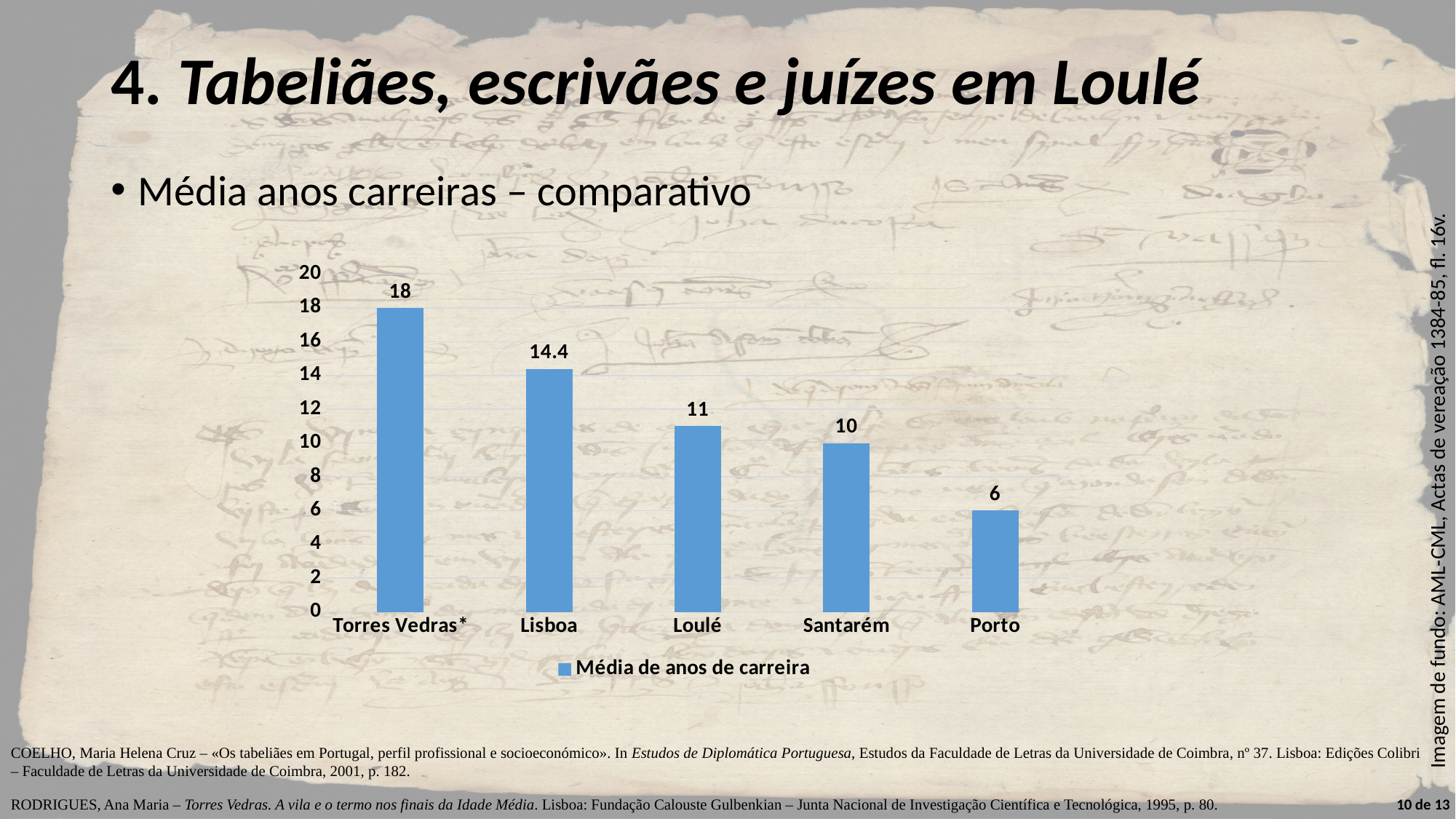
Which is larger, the value for Loulé or the value for Santarém? Loulé What is the difference between the values for Torres Vedras* and Lisboa? 3.6 How many categories are shown on the x axis? 5 Is the value for Lisboa greater or less than 12? greater What is the difference between the values for Santarém and Porto? 4 What is the value for Porto? 6 What kind of chart is shown on the slide? bar chart Which category has the lowest value? Porto What is the value for Lisboa? 14.4 Which category has the highest value? Torres Vedras* What is the legend entry for the series shown? Média de anos de carreira What is the value for Loulé? 11